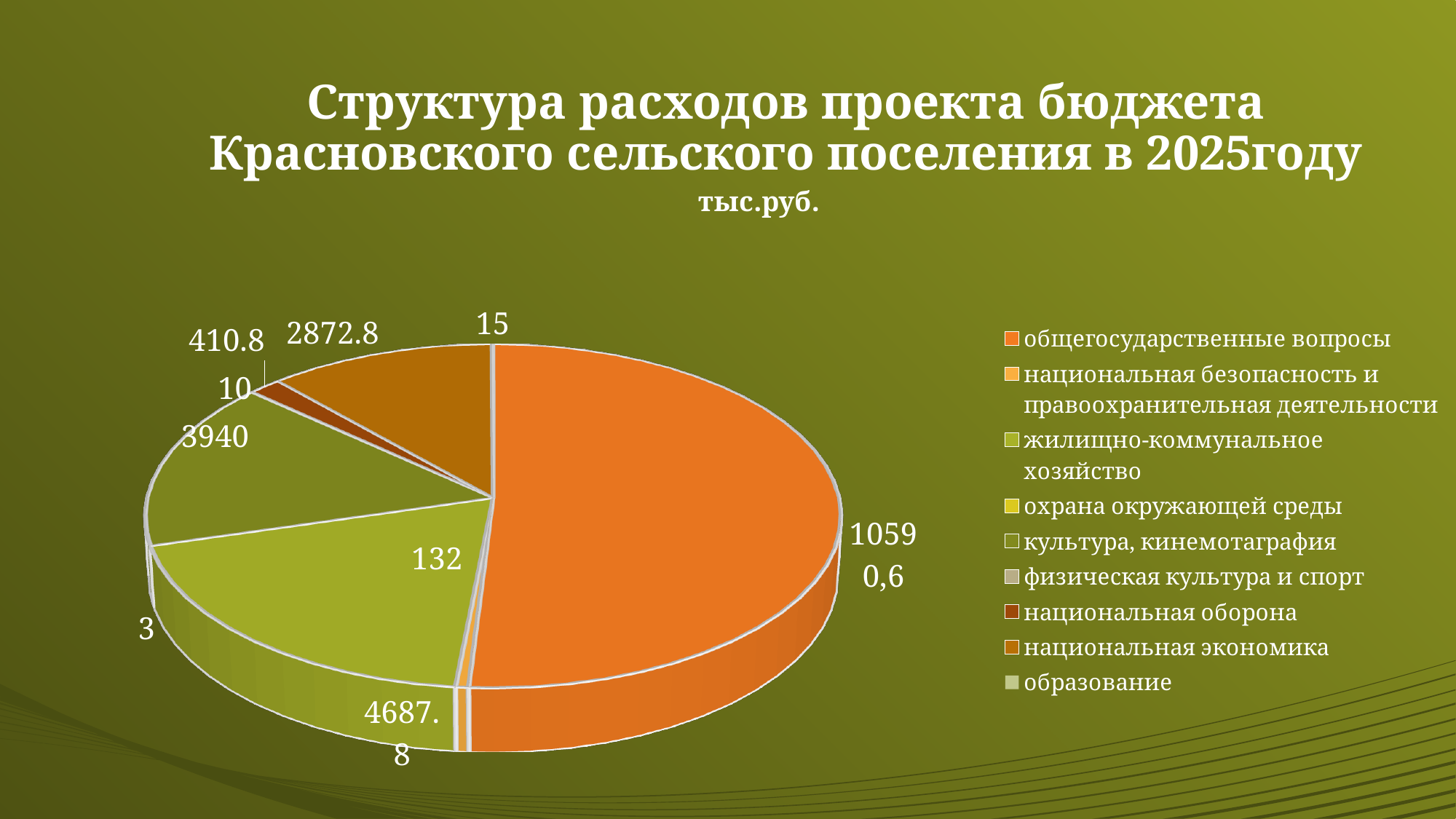
What kind of chart is shown on the slide? pie chart How many categories does the legend list? 9 What is the value for национальная экономика? 2872.8 What is the difference between национальная экономика (2872.8) and национальная оборона (410.8)? 2462 What is the value for жилищно-коммунальное хозяйство? 4687.8 What is the value for культура, кинемотаграфия? 3940 Which is larger, жилищно-коммунальное хозяйство or культура, кинемотаграфия? жилищно-коммунальное хозяйство What is the difference between жилищно-коммунальное хозяйство (4687.8) and культура, кинемотаграфия (3940)? 747.8 In what unit are the values on the chart given, according to the subtitle? тыс.руб. What is the value for национальная оборона? 410.8 Which category has the largest slice of the pie? общегосударственные вопросы What is the value for национальная безопасность и правоохранительная деятельности? 132